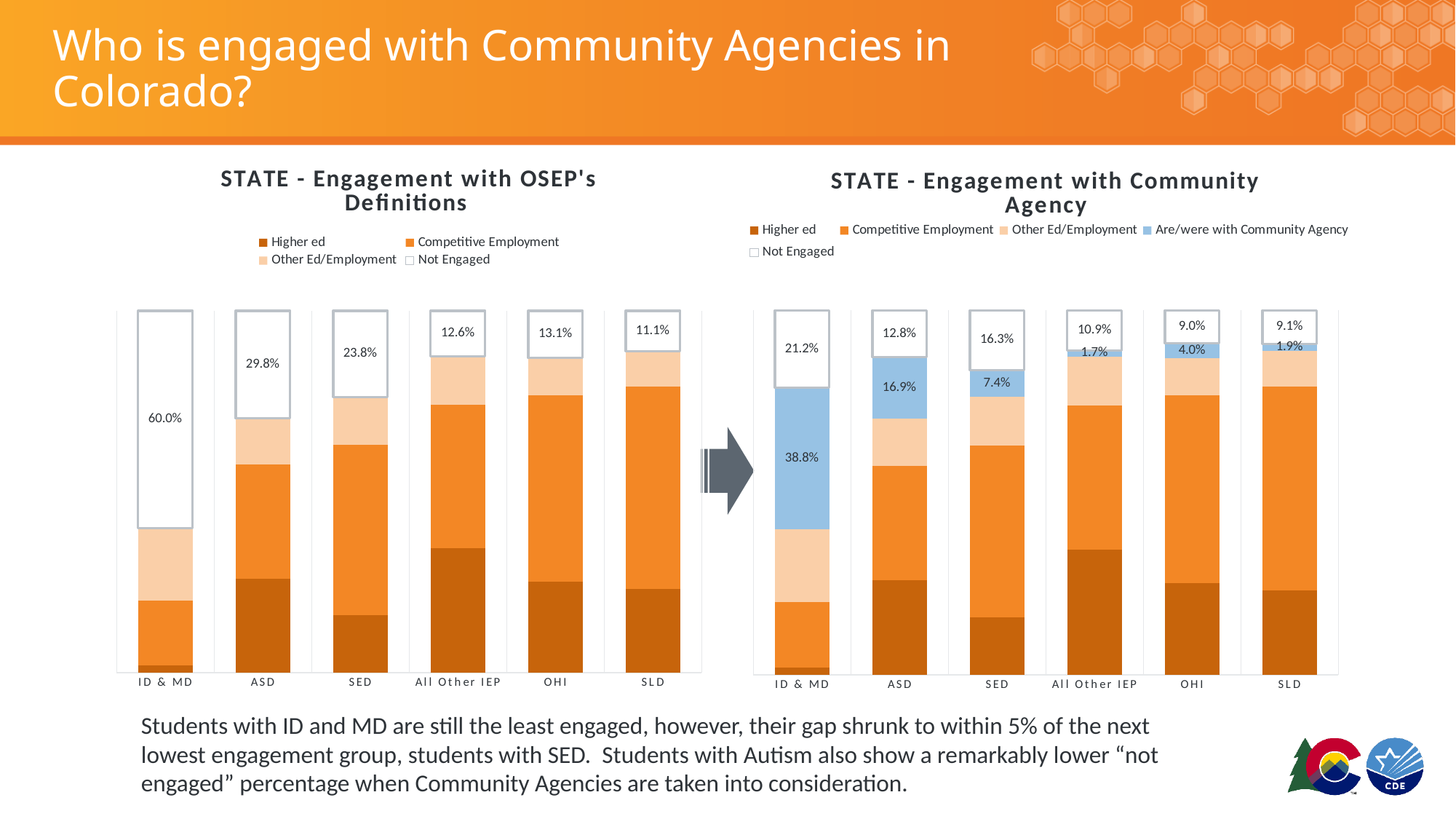
In the 'STATE - Engagement with Community Agency' chart, which is larger, the Are/were with Community Agency percentage for ASD or for SED? ASD In the 'STATE - Engagement with OSEP's Definitions' chart, what is the difference between the Not Engaged percentages for ASD and SED? 6.0% In the 'STATE - Engagement with OSEP's Definitions' chart, what is the Not Engaged percentage for ID & MD? 60.0% How many categories are shown on the x axis of the 'STATE - Engagement with OSEP's Definitions' chart? 6 How many series does the legend of the 'STATE - Engagement with Community Agency' chart list? 5 In the 'STATE - Engagement with Community Agency' chart, what is the Are/were with Community Agency percentage for ID & MD? 38.8% In the 'STATE - Engagement with Community Agency' chart, which category has the highest Not Engaged percentage? ID & MD In the 'STATE - Engagement with OSEP's Definitions' chart, what is the Not Engaged percentage for SED? 23.8% In the 'STATE - Engagement with Community Agency' chart, what is the difference between the Not Engaged percentages for ID & MD and SED? 4.9% In the 'STATE - Engagement with Community Agency' chart, what is the Not Engaged percentage for SED? 16.3% In the 'STATE - Engagement with Community Agency' chart, what is the Are/were with Community Agency percentage for OHI? 4.0% In the 'STATE - Engagement with OSEP's Definitions' chart, which category has the lowest Not Engaged percentage? SLD